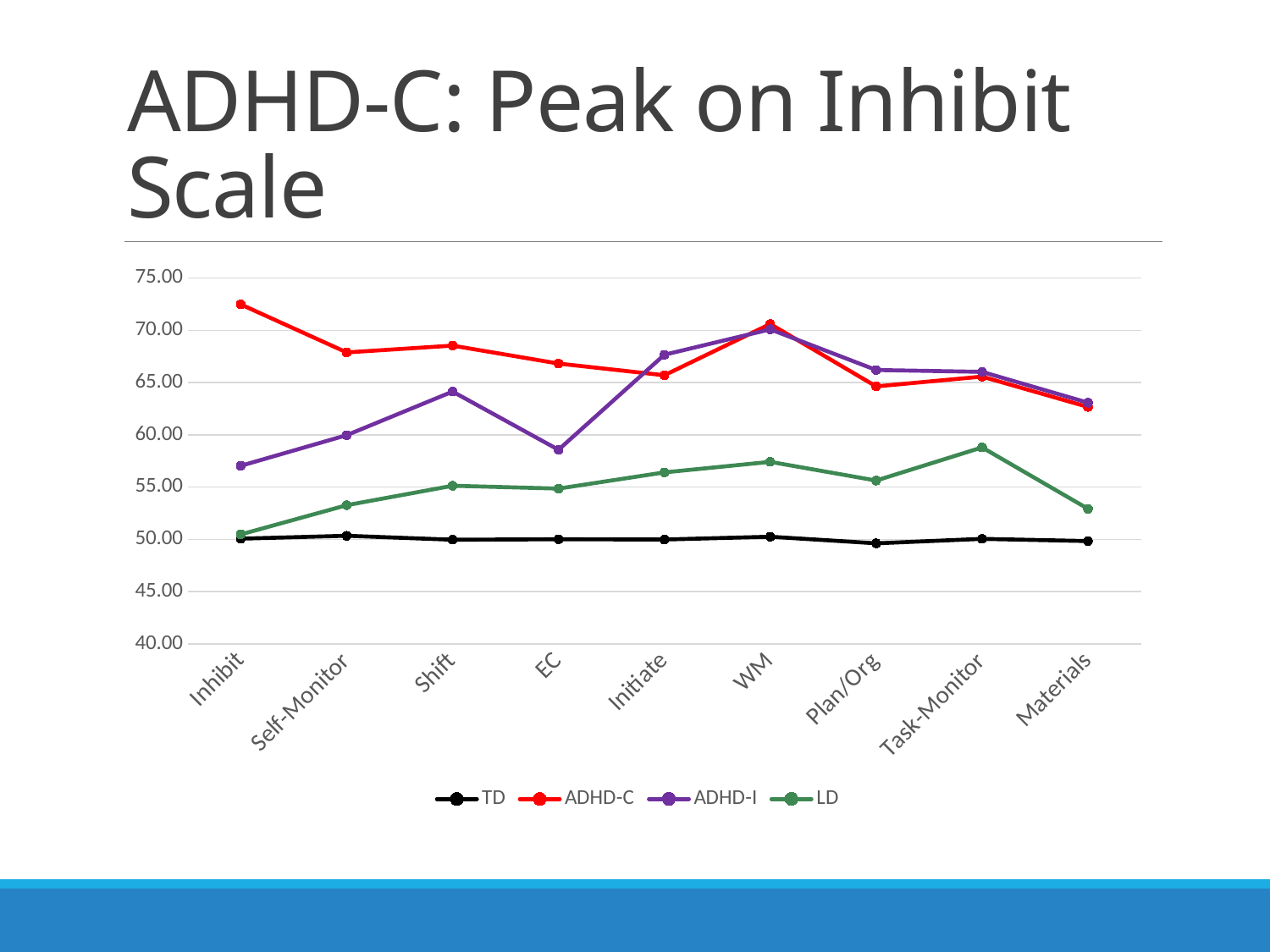
Is the ADHD-I value for Inhibit greater or less than 60.00? less For which category is the LD series lowest? Inhibit What colour is the ADHD-C series line? Red What kind of chart is shown on the slide? Line chart For which category is the ADHD-C series highest? Inhibit At Shift, which series has the larger value, ADHD-C or ADHD-I? ADHD-C How many series does the legend list? 4 Is the LD value for WM greater or less than 55.00? greater How many categories are shown on the x axis? 9 Is the ADHD-C value for Inhibit greater or less than 70.00? greater Does the ADHD-C series rise or fall from Inhibit to EC? fall At EC, which series has the larger value, ADHD-I or LD? ADHD-I